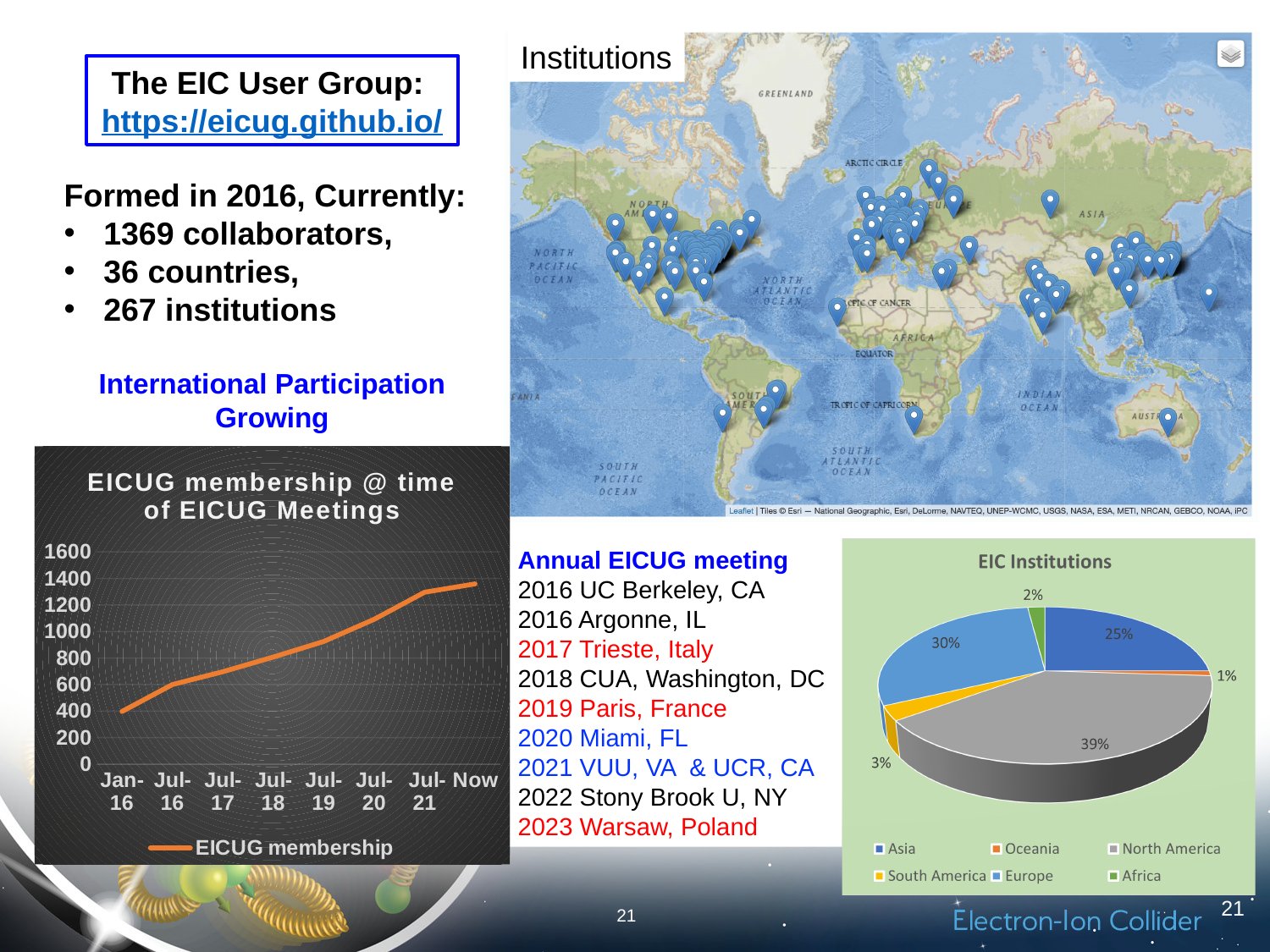
How many points are plotted along the x axis of the "EICUG membership @ time of EICUG Meetings" chart? 8 In the "EICUG membership @ time of EICUG Meetings" chart, is the value for Jan-16 greater or less than 600? less In the "EIC Institutions" pie chart, what share does Europe have? 30% In the "EIC Institutions" pie chart, what is the difference between the North America share and the Asia share? 14% In the "EICUG membership @ time of EICUG Meetings" chart, does membership rise or fall from Jan-16 to Now? rise How many series does the legend of the "EICUG membership @ time of EICUG Meetings" chart list? 1 What kind of chart is the "EIC Institutions" chart? pie chart In the "EICUG membership @ time of EICUG Meetings" chart, is the value for Now greater or less than 1200? greater In the "EIC Institutions" pie chart, which region has the smallest share? Oceania What kind of chart is the "EICUG membership @ time of EICUG Meetings" chart? line chart In the "EIC Institutions" pie chart, what share does North America have? 39% How many regions does the legend of the "EIC Institutions" pie chart list? 6